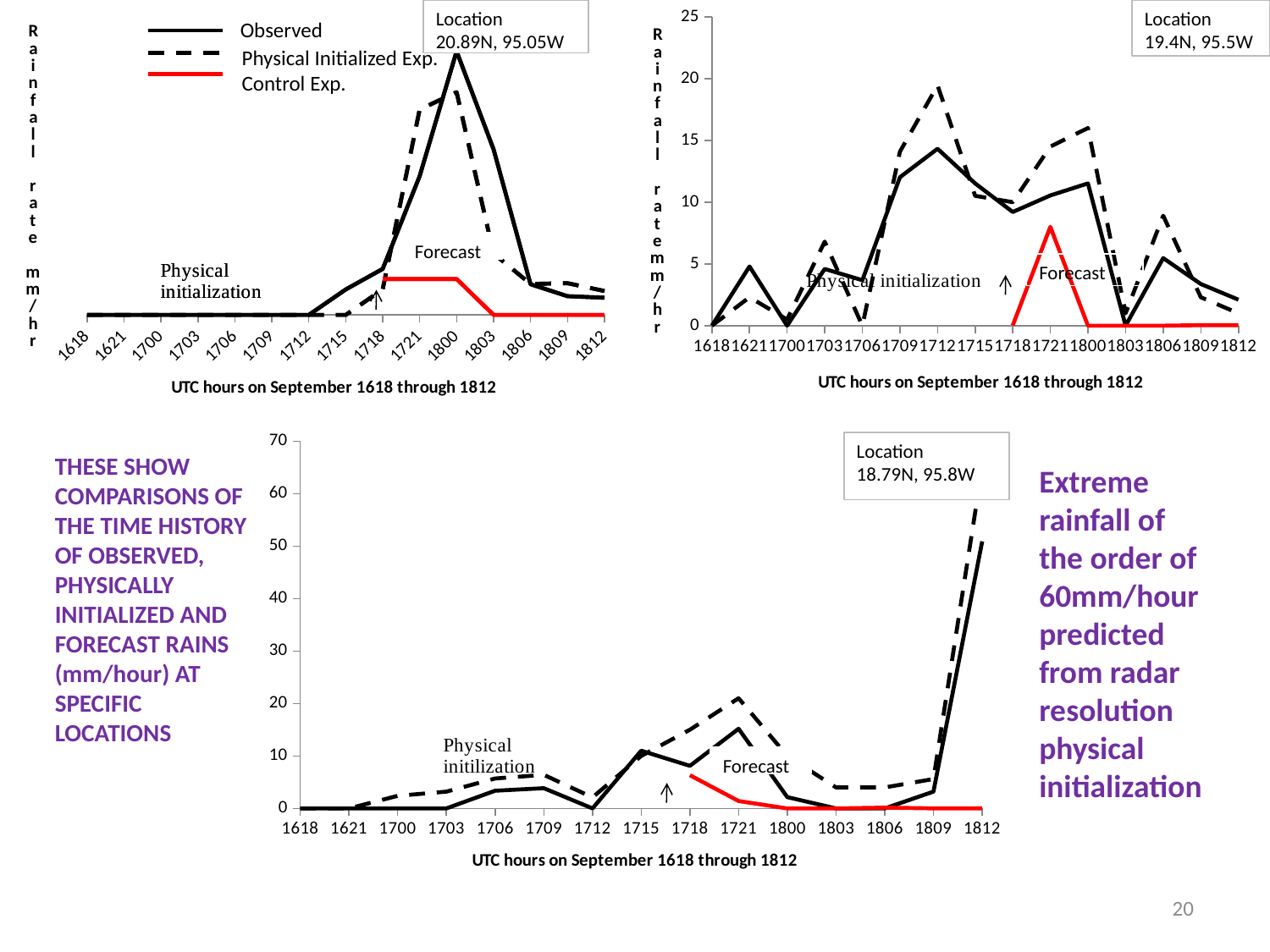
In the bottom chart (Location 18.79N, 95.8W), does the Observed series rise or fall from 1809 to 1812? Rise In the bottom chart (Location 18.79N, 95.8W), is the Control Exp. value at 1721 greater or less than 10? less In the top-right chart (Location 19.4N, 95.5W), is the Physical Initialized Exp. value at 1712 greater or less than 15? greater What type of chart is the bottom chart (Location 18.79N, 95.8W)? Line chart How many series does the legend on the top-left chart list? 3 How many time points are shown along the x axis of the bottom chart (Location 18.79N, 95.8W)? 15 In the top-right chart (Location 19.4N, 95.5W), at which hour does the Physical Initialized Exp. series reach its highest value? 1712 What is the x-axis title of the bottom chart (Location 18.79N, 95.8W)? UTC hours on September 1618 through 1812 In the bottom chart (Location 18.79N, 95.8W), is the Observed value at 1812 greater or less than 40? greater In the bottom chart (Location 18.79N, 95.8W), at which hour does the Observed series reach its highest value? 1812 In the top-right chart (Location 19.4N, 95.5W), at 1712, which is larger: the Observed value or the Physical Initialized Exp. value? Physical Initialized Exp.